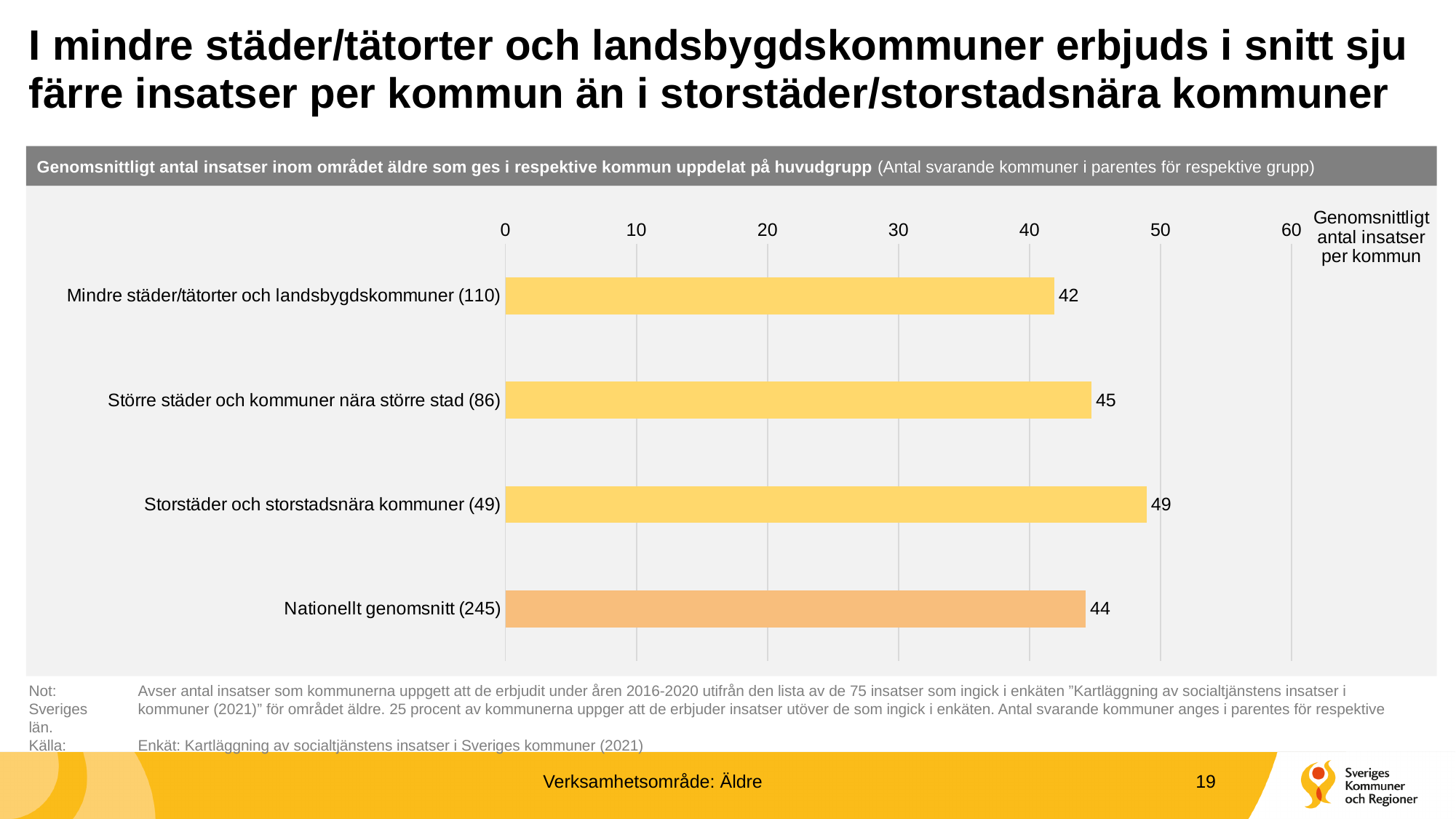
What is the average number of insatser per kommun for Mindre städer/tätorter och landsbygdskommuner (110)? 42 What kind of chart is shown on the slide? bar chart Which is larger: the value for Större städer och kommuner nära större stad (86) or the value for Nationellt genomsnitt (245)? Större städer och kommuner nära större stad (86) What is the value shown for Storstäder och storstadsnära kommuner (49)? 49 How many categories are shown in the chart? 4 Which bar is shown in a different colour (orange) from the others? Nationellt genomsnitt (245) What is the value shown for Nationellt genomsnitt (245)? 44 Which category has the lowest average number of insatser per kommun? Mindre städer/tätorter och landsbygdskommuner (110) What is the value shown for Större städer och kommuner nära större stad (86)? 45 Which category has the highest average number of insatser per kommun? Storstäder och storstadsnära kommuner (49) Is the value for Storstäder och storstadsnära kommuner (49) greater or less than 50? less What is the difference between the values for Storstäder och storstadsnära kommuner (49) and Mindre städer/tätorter och landsbygdskommuner (110)? 7